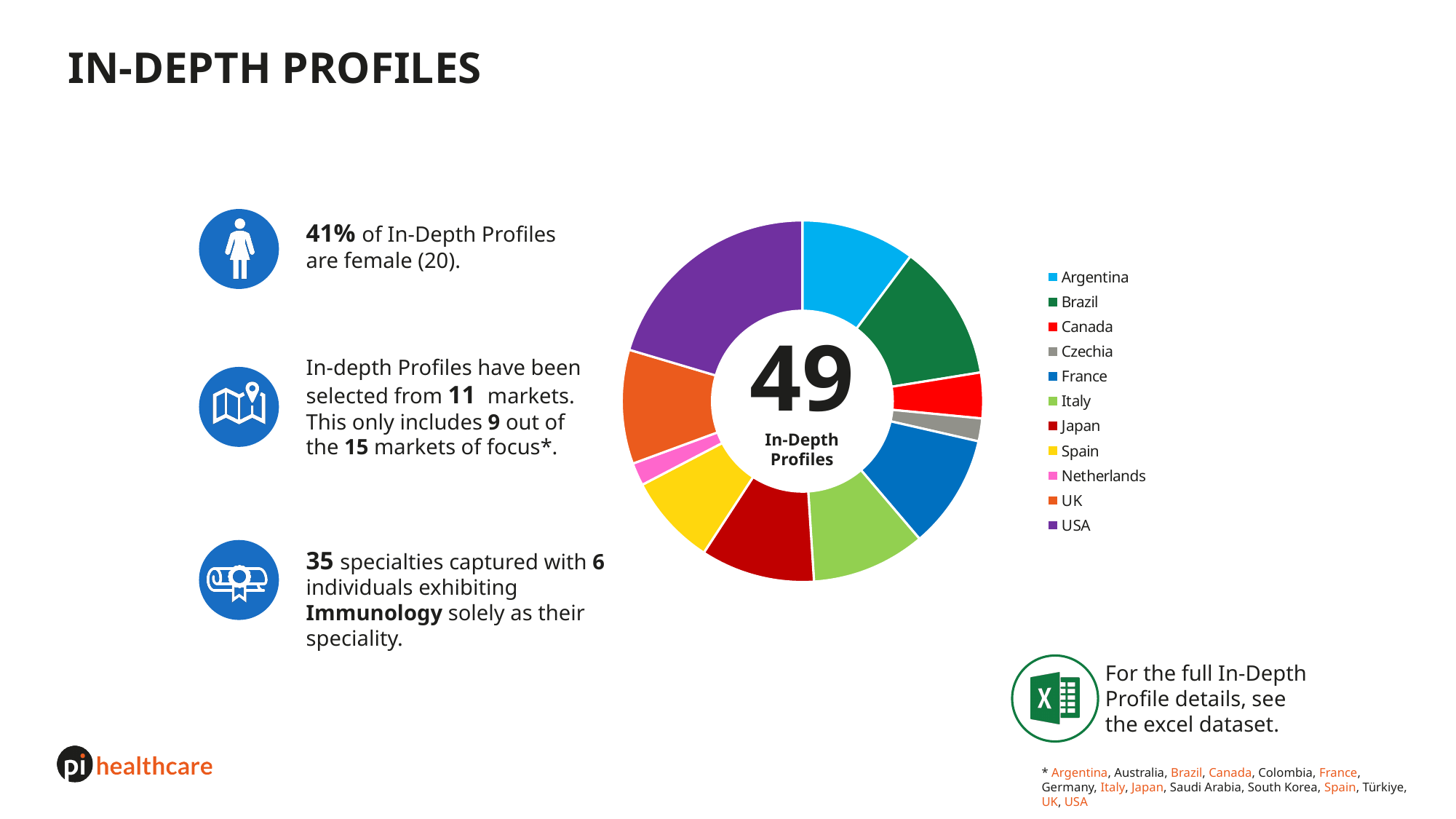
Which slice is larger in the In-Depth Profiles chart, USA or Argentina? USA What label appears in the centre of the donut chart below the number 49? In-Depth Profiles What number is printed in the centre of the In-Depth Profiles donut chart? 49 How many countries does the legend of the In-Depth Profiles chart list? 11 Which slice is larger in the In-Depth Profiles chart, UK or Netherlands? UK Which slice is larger in the In-Depth Profiles chart, Italy or Netherlands? Italy What colour represents USA in the In-Depth Profiles chart? Purple What type of chart is shown on the slide? Pie chart (donut) Which country has the largest slice in the In-Depth Profiles chart? USA